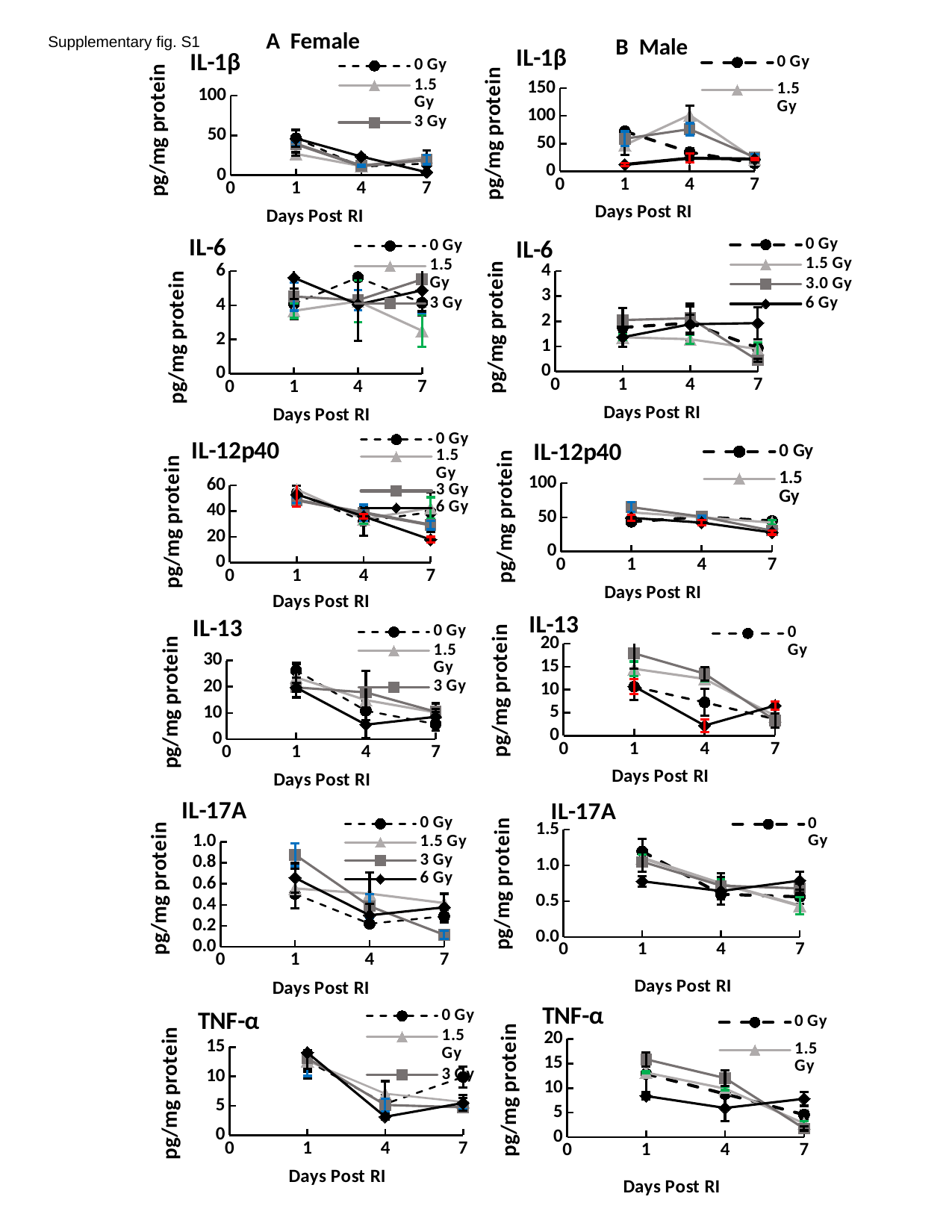
In the Female IL-17A chart, is the value for 0 Gy at day 4 greater or less than 0.4? less How many series does the legend of the Female IL-17A chart list? 4 How many time points are plotted along the x axis of the Male IL-12p40 chart? 3 In the Male IL-1β chart, is the value for 1.5 Gy at day 4 greater or less than 50? greater What is the x-axis label on the Female TNF-α chart? Days Post RI What is the y-axis label on the Male IL-17A chart? pg/mg protein In the Female IL-12p40 chart, is the value for 6 Gy at day 7 greater or less than 40? less What kind of chart is the Female IL-1β chart? line chart How many series does the legend of the Male IL-6 chart list? 4 How many series does the legend of the Male IL-1β chart list? 2